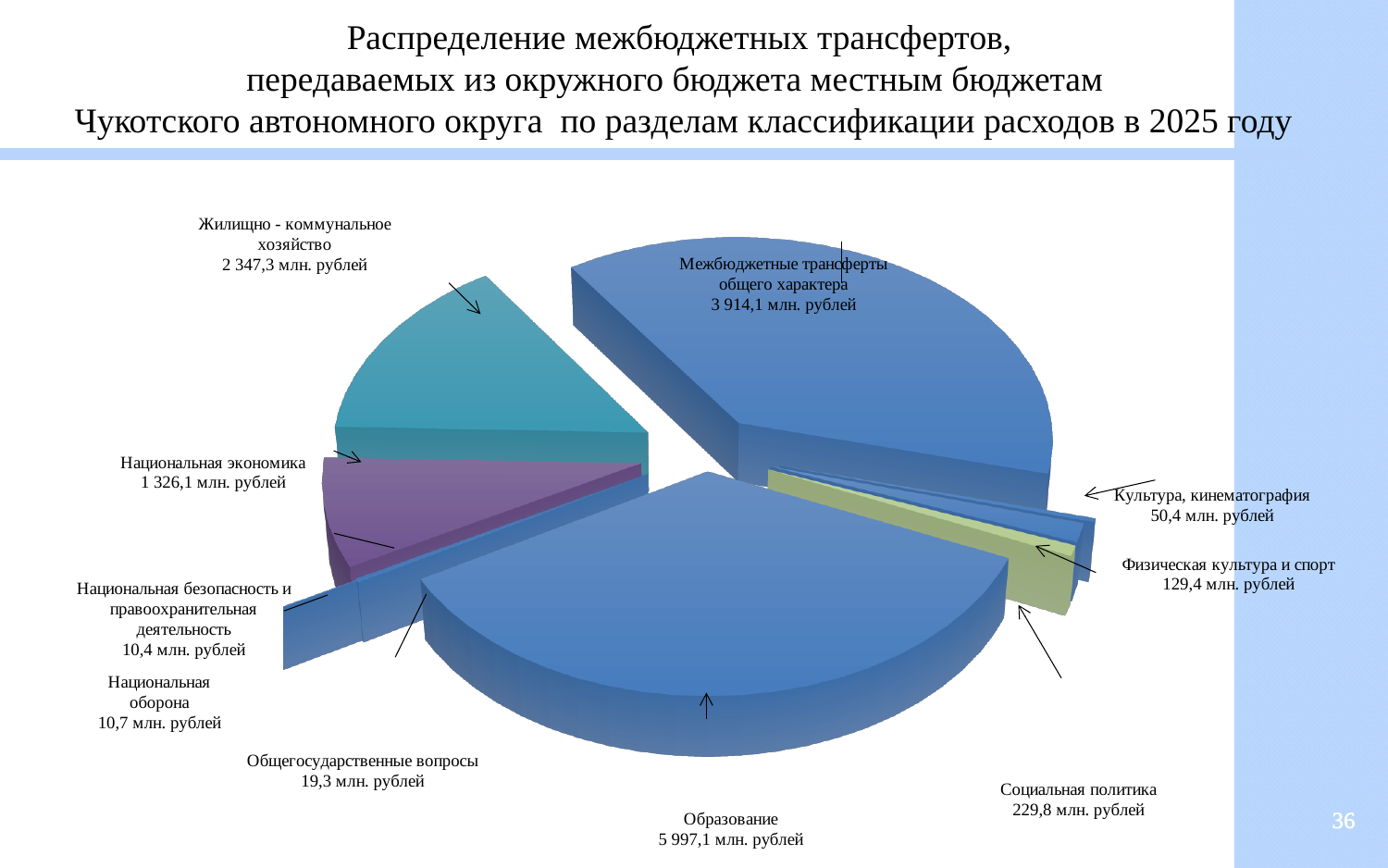
What is the difference between the values for Образование and Межбюджетные трансферты общего характера? 2 083,0 млн. рублей What is the difference between the values for Жилищно-коммунальное хозяйство and Национальная экономика? 1 021,2 млн. рублей What is the value for Межбюджетные трансферты общего характера? 3 914,1 млн. рублей How many categories (slices) does the pie chart show? 10 Which category has the largest value in the pie chart? Образование What type of chart is shown on the slide? Pie chart What is the value for Социальная политика? 229,8 млн. рублей What is the value for Образование? 5 997,1 млн. рублей Which is larger: the value for Физическая культура и спорт or the value for Культура, кинематография? Физическая культура и спорт Which category has the smallest value in the pie chart? Национальная безопасность и правоохранительная деятельность For which year does the chart show the distribution of inter-budget transfers? 2025 What is the value for Жилищно-коммунальное хозяйство? 2 347,3 млн. рублей